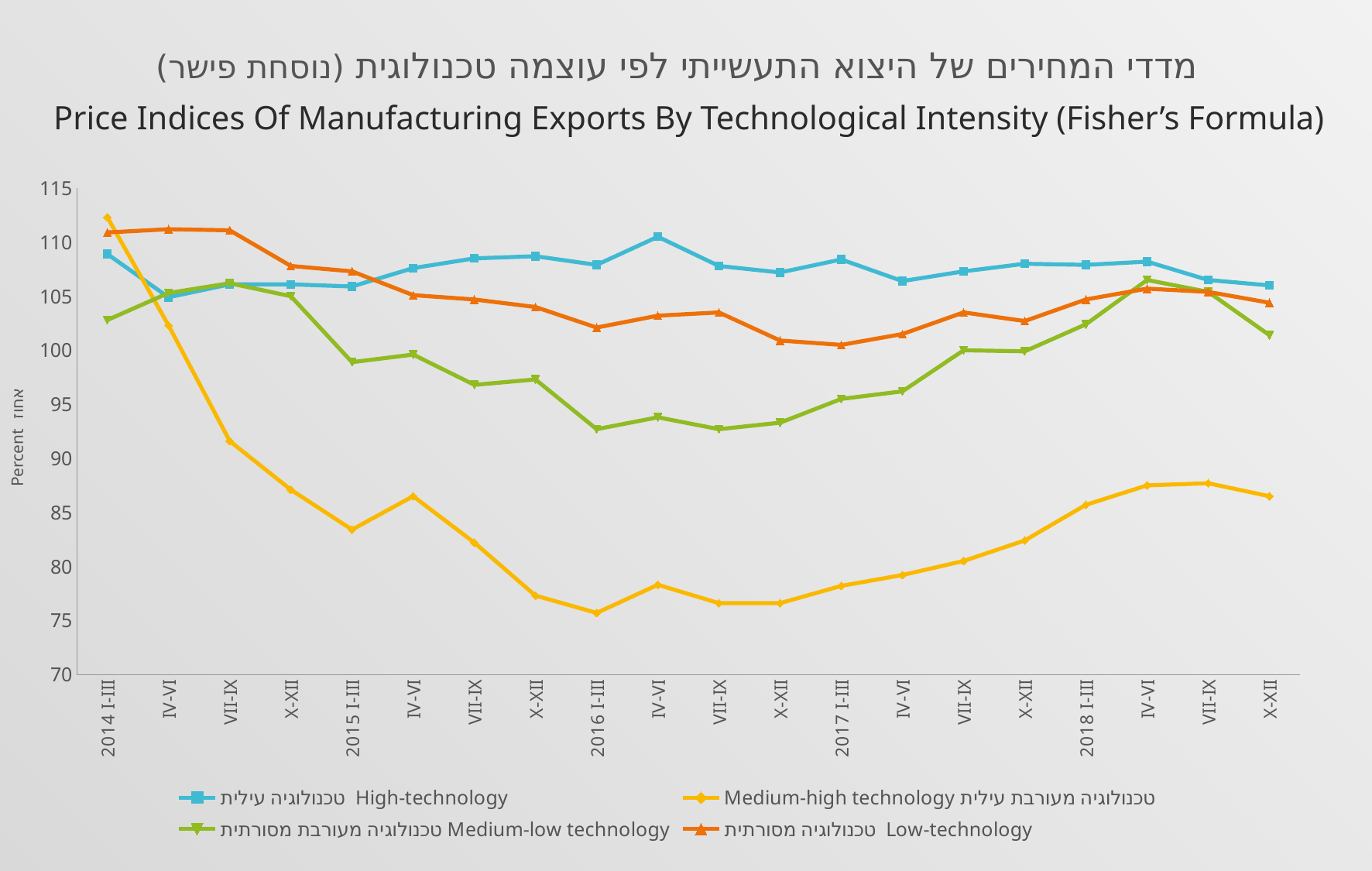
What is the label on the y axis? Percent אחוז At 2014 I-III, which is larger: the value for Medium-high technology or the value for High-technology? Medium-high technology How many series does the legend list? 4 Is the value for Medium-high technology at 2016 I-III greater or less than 80? less What kind of chart is shown on the slide? Line chart Which series has the lowest value at 2018 X-XII? Medium-high technology Is the value for Medium-low technology at 2016 VII-IX greater or less than 95? less Is the value for Low-technology at 2014 I-III greater or less than 110? greater Does the Medium-high technology series rise or fall from 2014 I-III to 2016 I-III? Fall Which series has the highest value at 2016 I-III? High-technology How many time periods are plotted along the x axis? 20